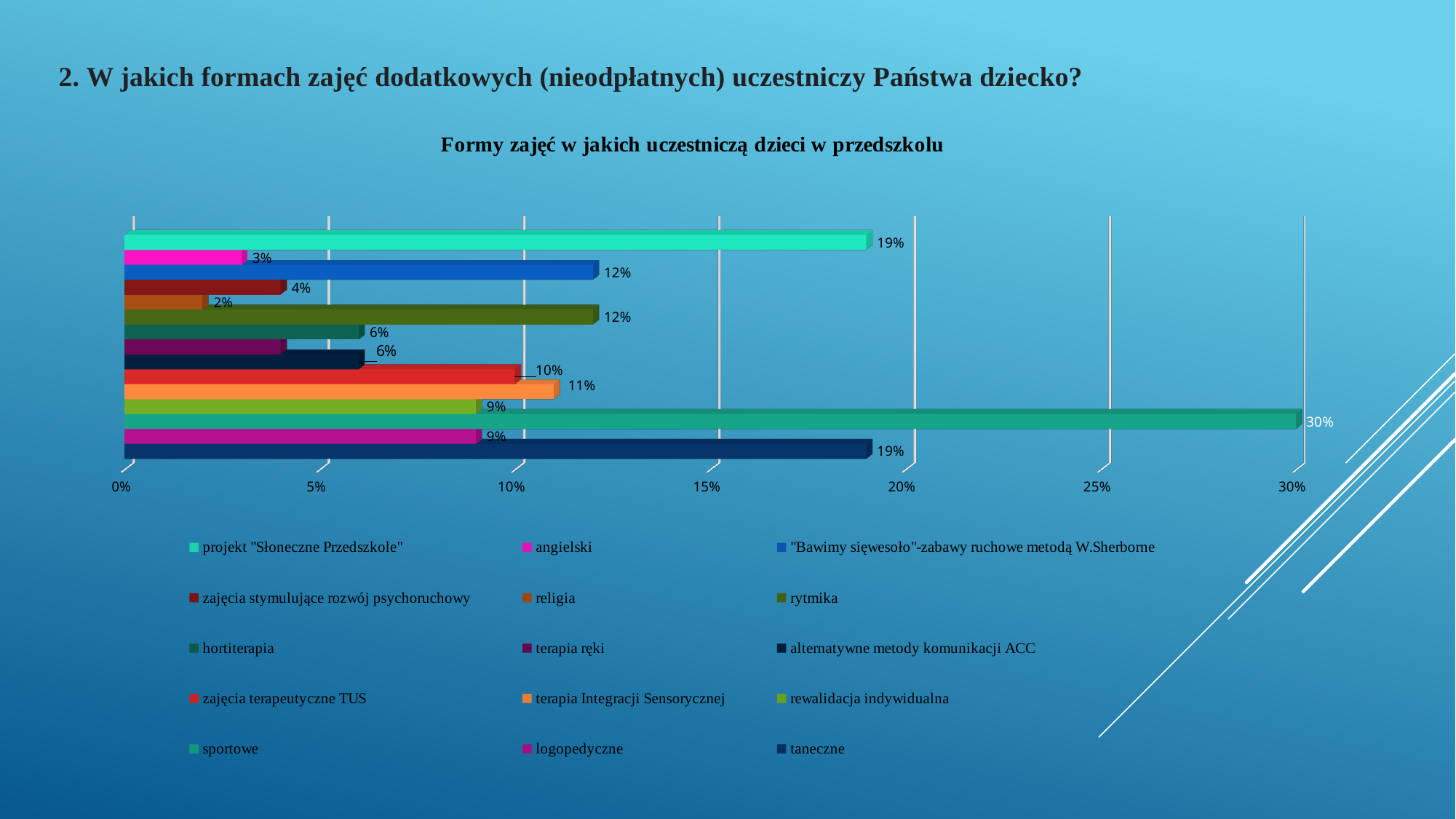
What kind of chart is shown on the slide? bar chart Which category has the lowest value? religia What is the value for sportowe? 30% What is the value for angielski? 3% Is the value for terapia ręki greater or less than 5%? less How many series does the legend list? 15 Which category has the highest value? sportowe What is the value for terapia Integracji Sensorycznej? 11% What is the difference between the values for sportowe and taneczne? 11 percentage points What is the value for taneczne? 19% Which is larger, the value for "Bawimy się wesoło"-zabawy ruchowe metodą W.Sherborne or the value for angielski? "Bawimy się wesoło"-zabawy ruchowe metodą W.Sherborne What is the chart's title? Formy zajęć w jakich uczestniczą dzieci w przedszkolu